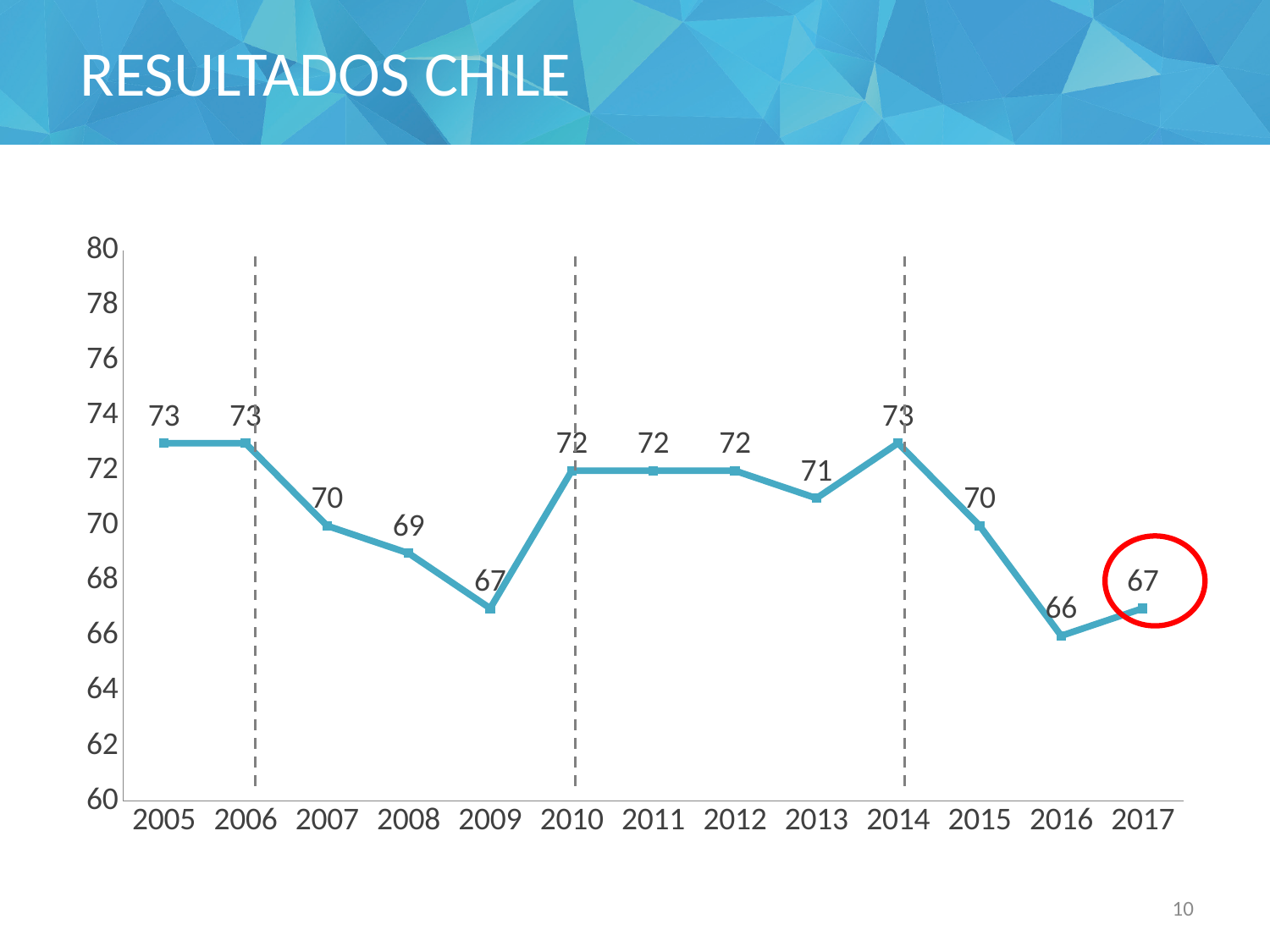
Do the values rise or fall from 2014 to 2016? fall Which year has the lowest value? 2016 What is the value for 2017? 67 What is the difference between the values for 2014 and 2016? 7 Is the value for 2016 greater or less than 68? less What is the value for 2013? 71 What kind of chart is shown on the slide? line chart What is the value for 2009? 67 What is the difference between the values for 2005 and 2017? 6 Which is larger, the value for 2010 or the value for 2015? 2010 How many years are plotted on the x axis? 13 Which data point is circled in red on the chart? 2017